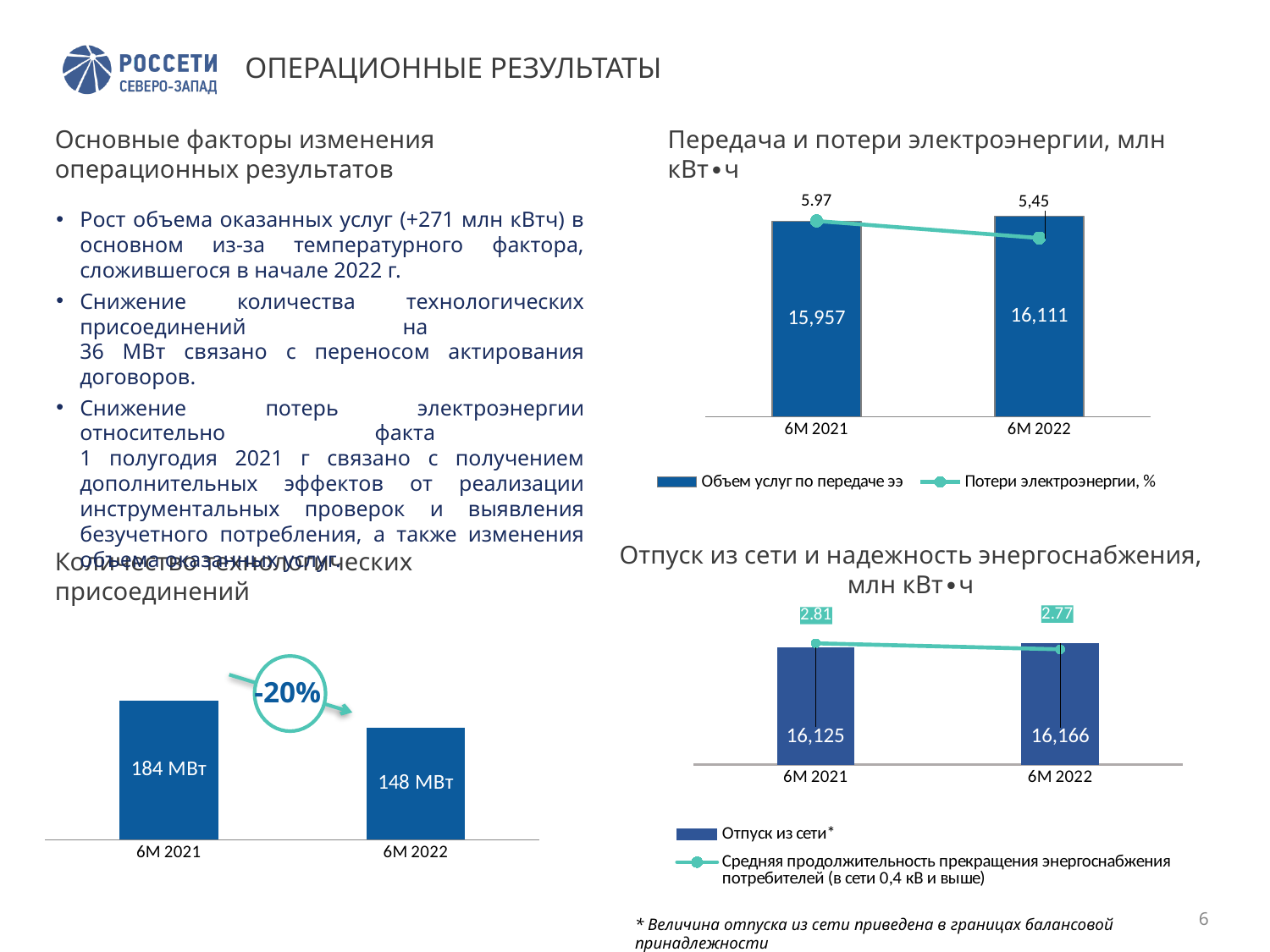
In the chart 'Отпуск из сети и надежность энергоснабжения, млн кВт•ч', what is the value of 'Отпуск из сети' for 6M 2021? 16,125 What kind of chart is 'Количество технологических присоединений'? bar chart In the chart 'Отпуск из сети и надежность энергоснабжения, млн кВт•ч', what is the value of the line series for 6M 2022? 2.77 In the chart 'Количество технологических присоединений', what is the value for 6M 2021? 184 МВт In the chart 'Передача и потери электроэнергии, млн кВт•ч', how many series does the legend list? 2 In the chart 'Передача и потери электроэнергии, млн кВт•ч', what is the value of 'Объем услуг по передаче ээ' for 6M 2022? 16,111 In the chart 'Количество технологических присоединений', what percentage change is shown in the circle between the two bars? -20% In the chart 'Передача и потери электроэнергии, млн кВт•ч', what is the value of 'Потери электроэнергии, %' for 6M 2021? 5.97 In the chart 'Передача и потери электроэнергии, млн кВт•ч', which period has the higher value of 'Объем услуг по передаче ээ'? 6M 2022 In the chart 'Передача и потери электроэнергии, млн кВт•ч', does 'Потери электроэнергии, %' rise or fall from 6M 2021 to 6M 2022? fall In the chart 'Отпуск из сети и надежность энергоснабжения, млн кВт•ч', how many periods are shown on the x axis? 2 In the chart 'Количество технологических присоединений', what is the difference between the 6M 2021 and 6M 2022 values? 36 МВт